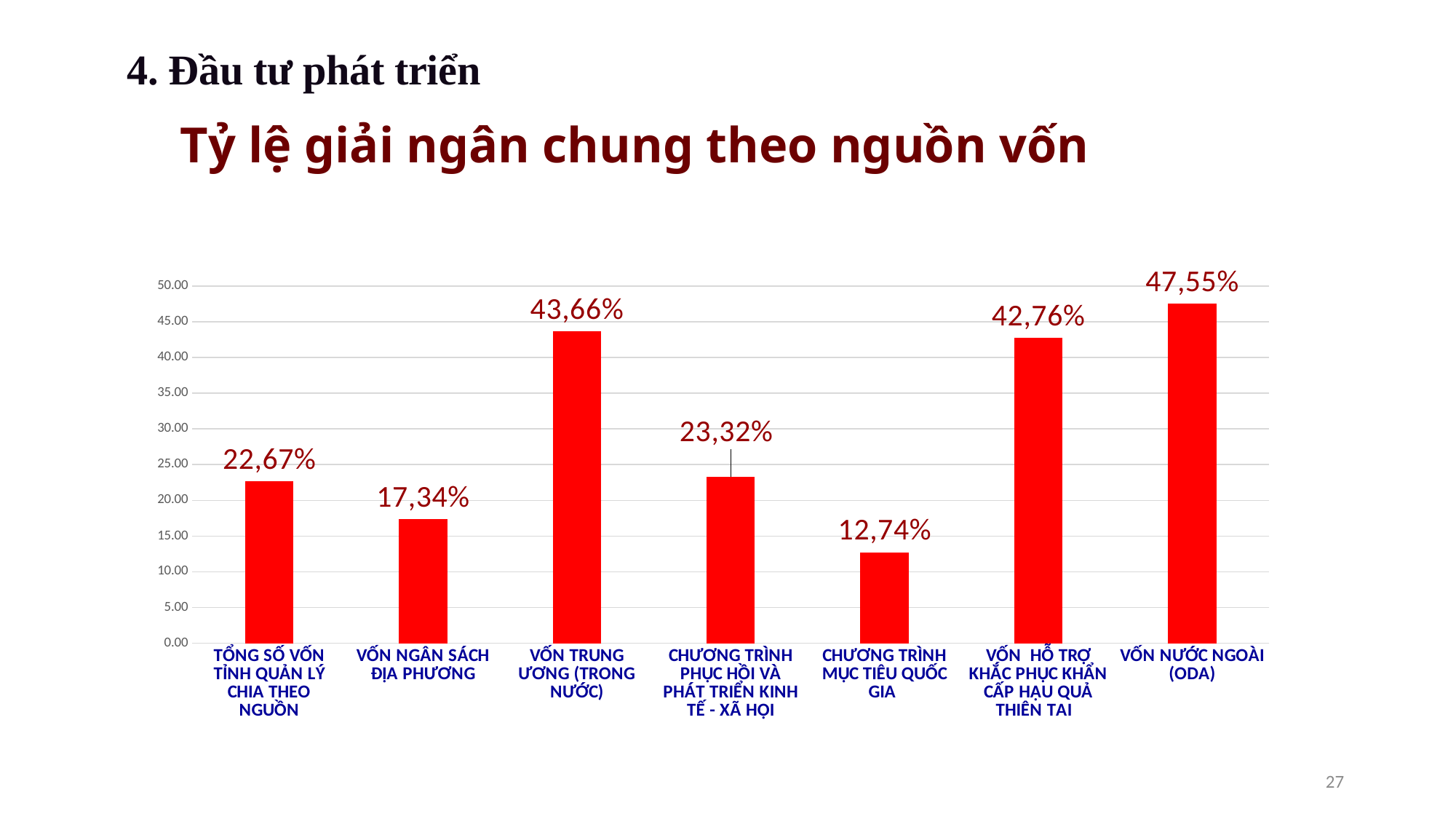
What is the value for CHƯƠNG TRÌNH PHỤC HỒI VÀ PHÁT TRIỂN KINH TẾ - XÃ HỘI? 23,32% What is the value for VỐN NGÂN SÁCH ĐỊA PHƯƠNG? 17,34% Which category has the lowest value? CHƯƠNG TRÌNH MỤC TIÊU QUỐC GIA What is the value for VỐN NƯỚC NGOÀI (ODA)? 47,55% Which is larger, the value for VỐN TRUNG ƯƠNG (TRONG NƯỚC) or the value for VỐN NGÂN SÁCH ĐỊA PHƯƠNG? VỐN TRUNG ƯƠNG (TRONG NƯỚC) Which category has the highest value? VỐN NƯỚC NGOÀI (ODA) What kind of chart is shown on the slide? bar chart How many categories are shown in the chart? 7 What is the difference between the values for VỐN NƯỚC NGOÀI (ODA) and CHƯƠNG TRÌNH MỤC TIÊU QUỐC GIA? 34,81% What is the value for VỐN HỖ TRỢ KHẮC PHỤC KHẨN CẤP HẬU QUẢ THIÊN TAI? 42,76% Is the value for TỔNG SỐ VỐN TỈNH QUẢN LÝ CHIA THEO NGUỒN greater or less than 25.00? less What is the title of the chart? Tỷ lệ giải ngân chung theo nguồn vốn